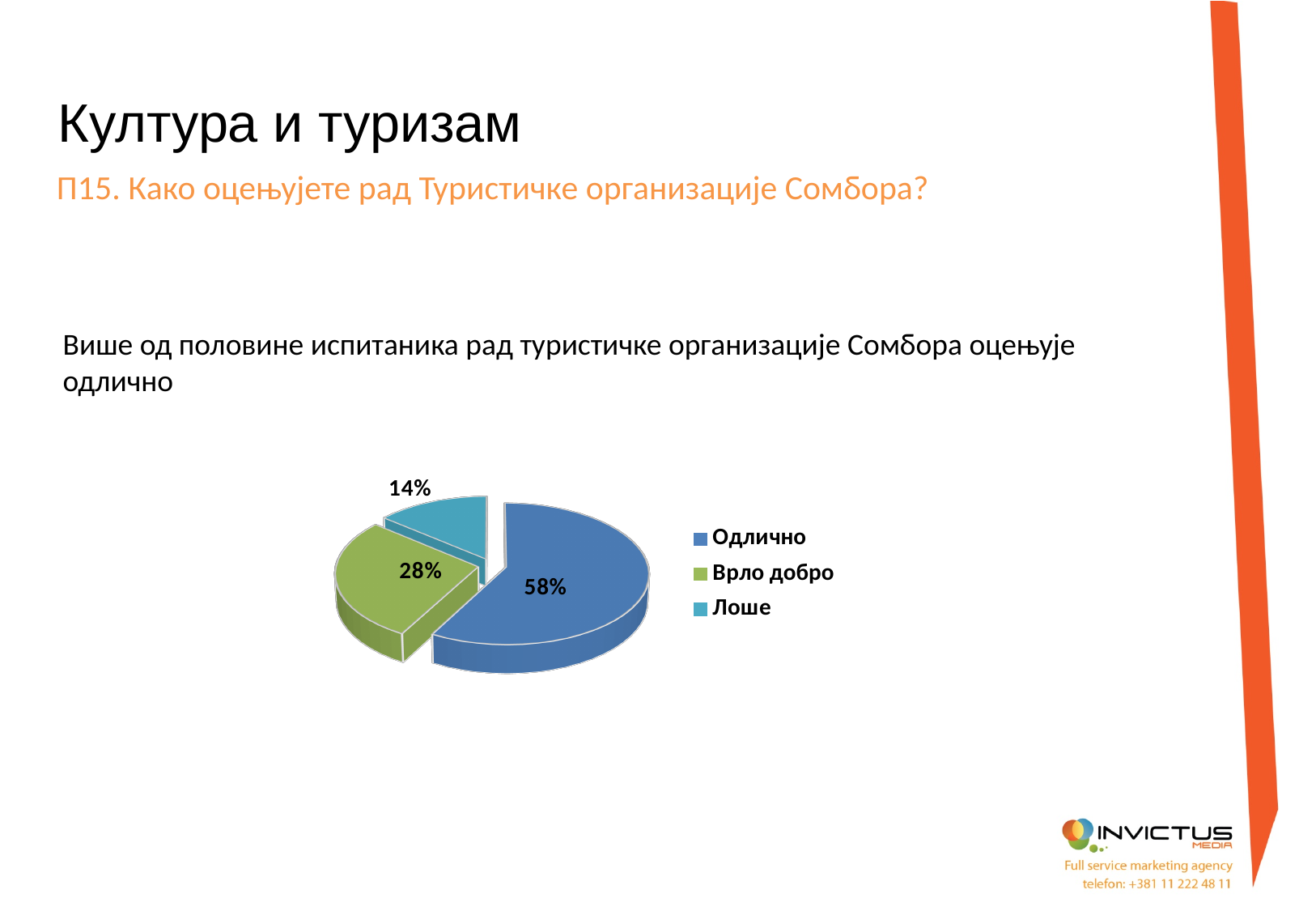
Which is larger, the share for Врло добро or the share for Лоше? Врло добро What is the difference in percentage points between Одлично and Врло добро? 30 Which category has the largest share of the pie? Одлично What colour is the slice for Одлично? Blue How many categories does the pie chart show? 3 What is the combined share of Одлично and Врло добро? 86% What share of respondents rated the work of the Tourist Organization of Sombor as Одлично? 58% What is the difference in percentage points between Врло добро and Лоше? 14 Which category has the smallest share of the pie? Лоше What type of chart is shown on the slide? Pie chart What share of respondents answered Врло добро? 28% What share of respondents answered Лоше? 14%